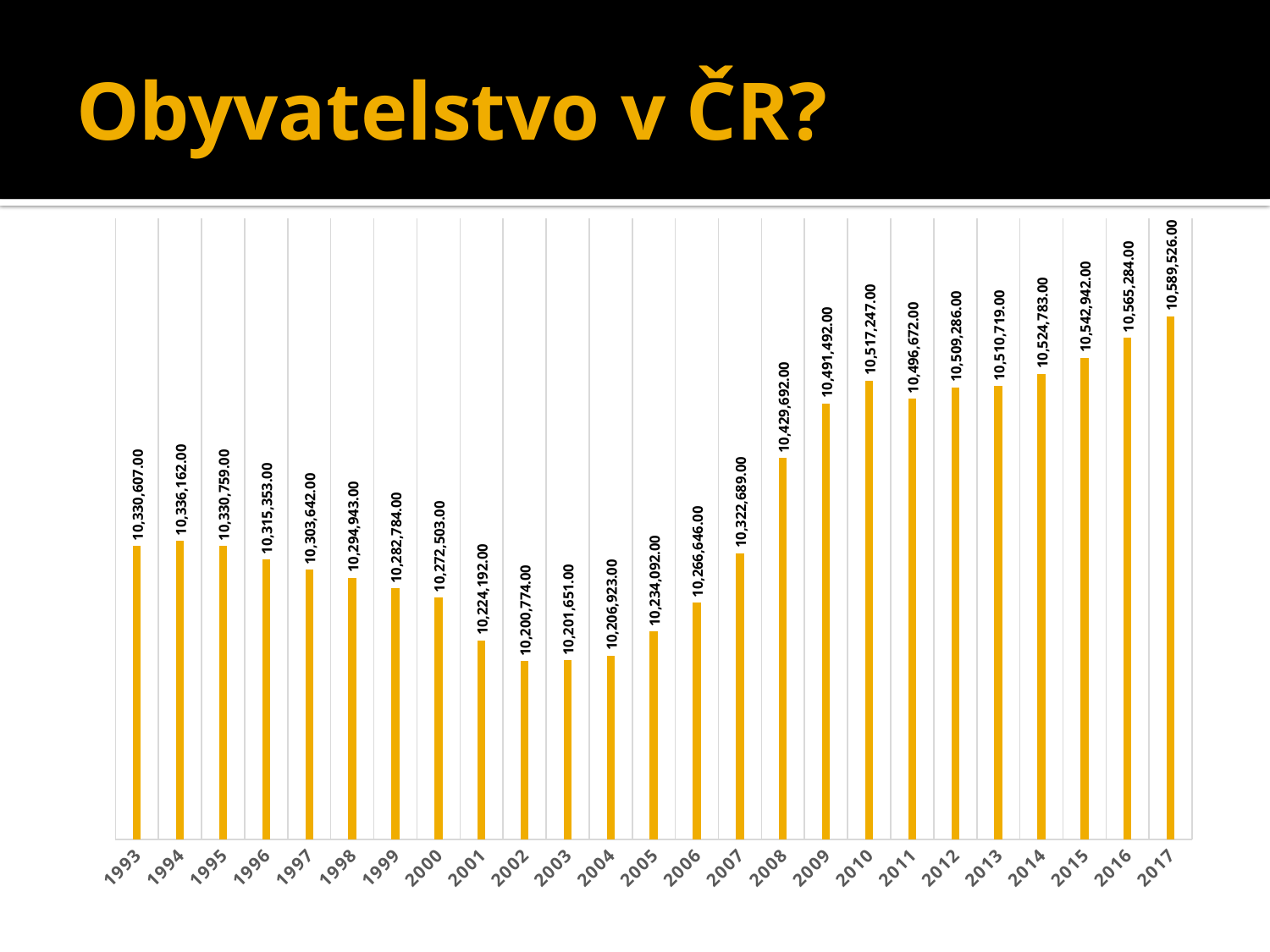
What is the value for 2017? 10,589,526.00 What is the value for 1993? 10,330,607.00 What is the difference between the values for 2017 and 1993? 258,919.00 What is the value for 2008? 10,429,692.00 What kind of chart is shown on the slide? bar chart Which year has the lowest value? 2002 What is the title of the slide? Obyvatelstvo v ČR? Which year has the highest value? 2017 How many years are shown on the x axis? 25 Which is larger, the value for 2007 or the value for 2008? 2008 Do the values rise or fall from 2011 to 2017? rise What is the difference between the values for 2010 and 2009? 25,755.00